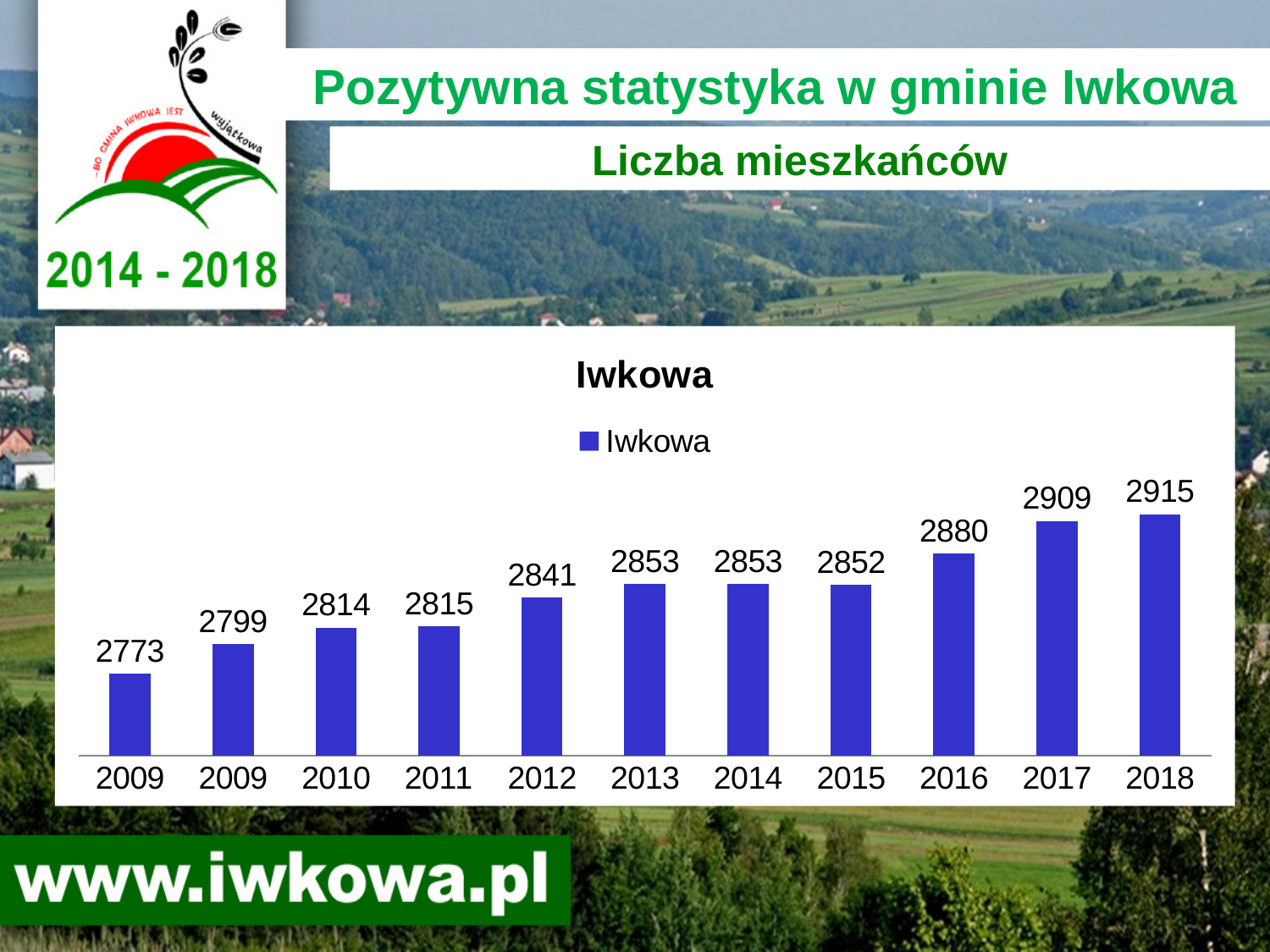
What is the value for 2012? 2841 Which is larger, the value for 2013 or the value for 2015? 2013 Which year has the highest value? 2018 How many bars are shown on the chart? 11 What is the lowest value shown on the chart? 2773 What kind of chart is shown? bar chart What is the difference between the values for 2016 and 2015? 28 What is the difference between the values for 2018 and 2017? 6 How many series does the legend list? 1 What is the value for 2018? 2915 Do the values generally rise or fall from left to right along the x axis? rise What is the value for 2016? 2880